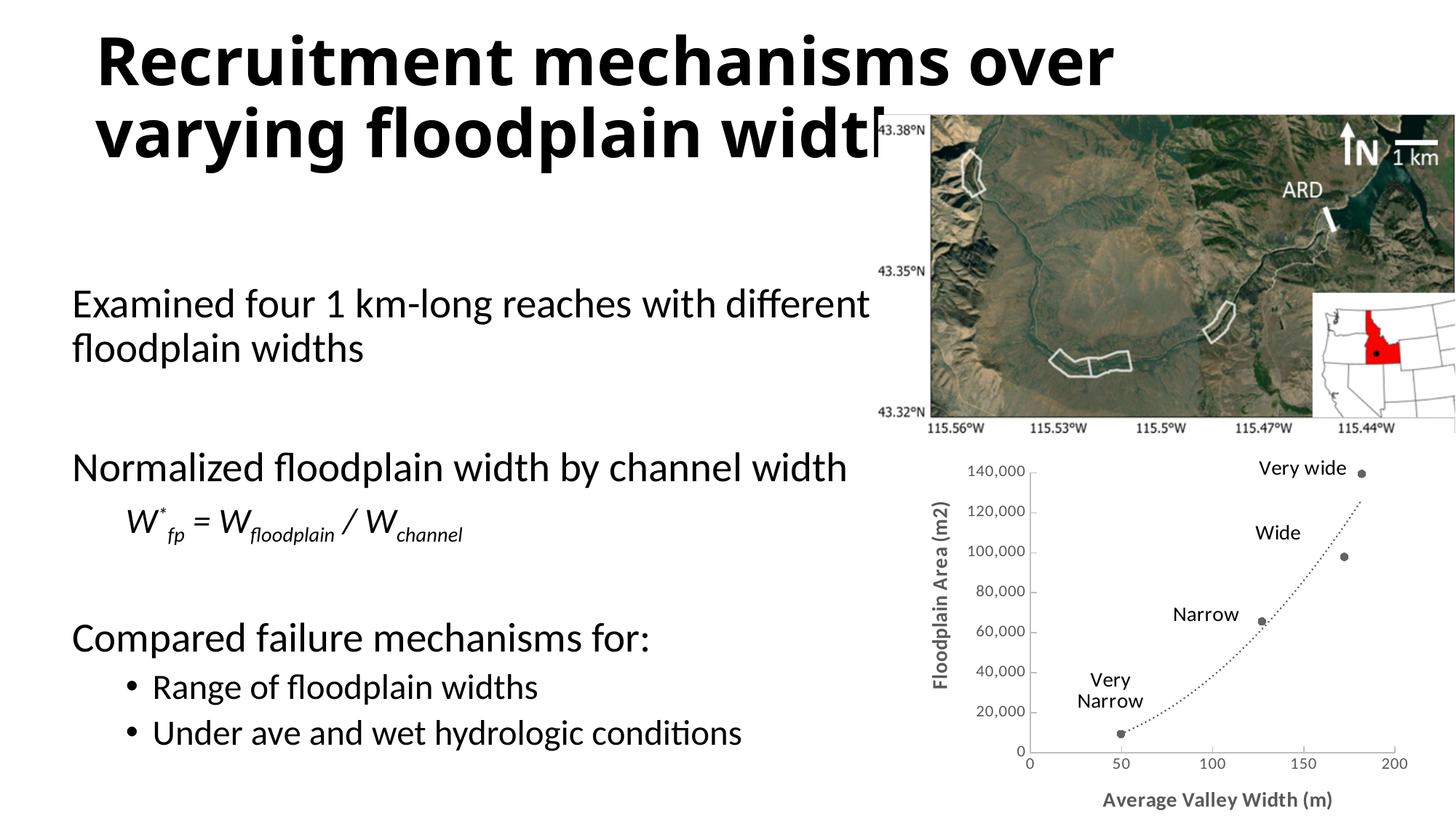
Which has a larger floodplain area, Narrow or Wide? Wide Is the average valley width for the Wide point greater or less than 150? greater Is the floodplain area for the Narrow point greater or less than 80,000? less What is the title of the x axis of the scatter chart? Average Valley Width (m) How many data points are plotted in the scatter chart? 4 Does floodplain area rise or fall as average valley width increases? rise What is the title of the y axis of the scatter chart? Floodplain Area (m2) Is the floodplain area for the Very wide point greater or less than 120,000? greater What kind of chart is shown at the bottom right of the slide? scatter chart Which labelled point has the highest floodplain area? Very wide Which labelled point has the lowest floodplain area? Very Narrow